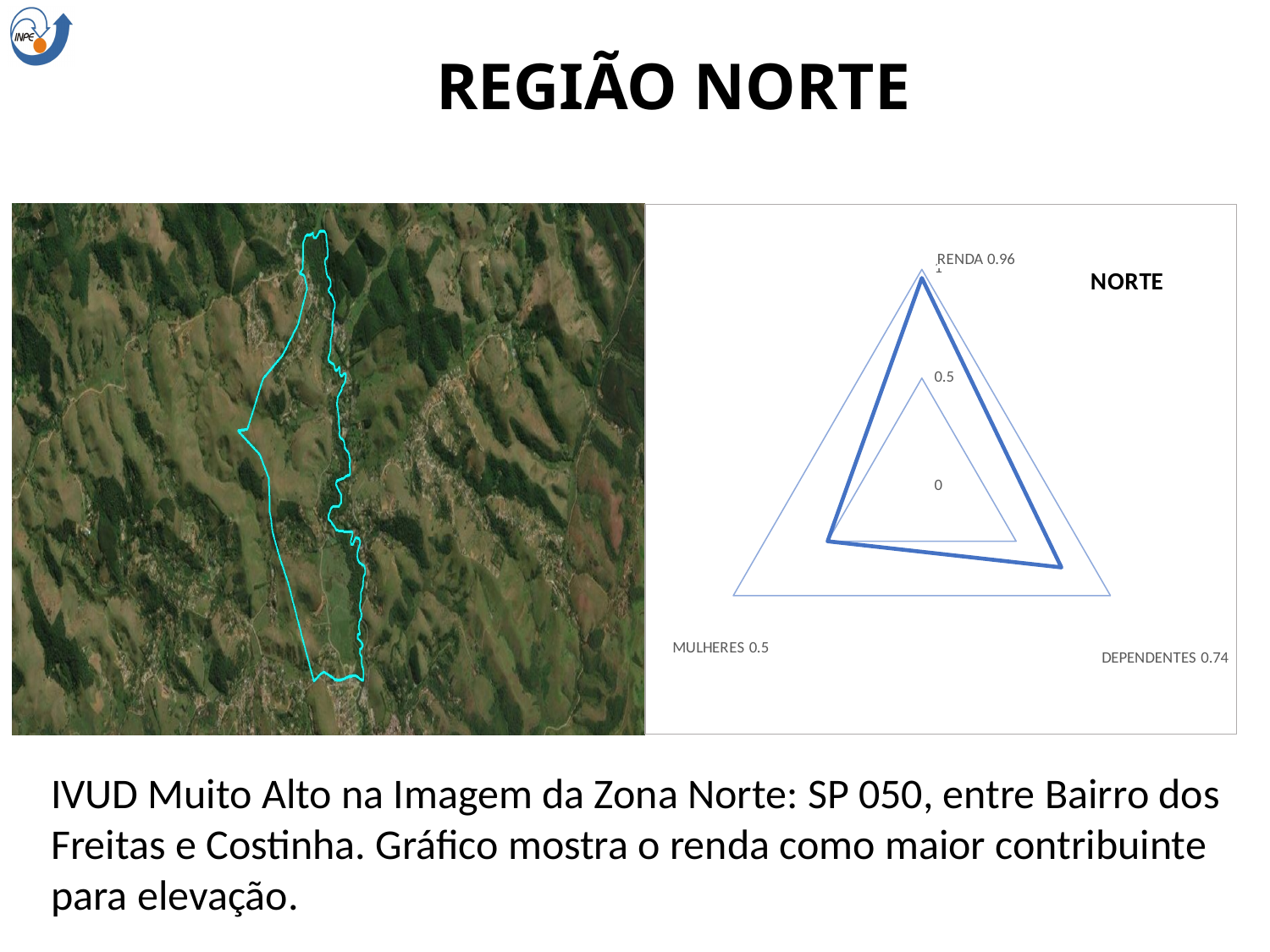
What is the difference between the DEPENDENTES and MULHERES values in the radar chart? 0.24 Which is larger in the radar chart, the value for DEPENDENTES or the value for MULHERES? DEPENDENTES What kind of chart is shown on the right of the slide? radar chart How many categories (axes) does the radar chart have? 3 What is the title shown on the radar chart? NORTE What is the value for DEPENDENTES in the radar chart? 0.74 Which category has the highest value in the radar chart? RENDA What is the value for RENDA in the radar chart? 0.96 Which category has the lowest value in the radar chart? MULHERES What is the difference between the RENDA and DEPENDENTES values in the radar chart? 0.22 What is the value for MULHERES in the radar chart? 0.5 Is the value for RENDA in the radar chart greater or less than 0.5? greater